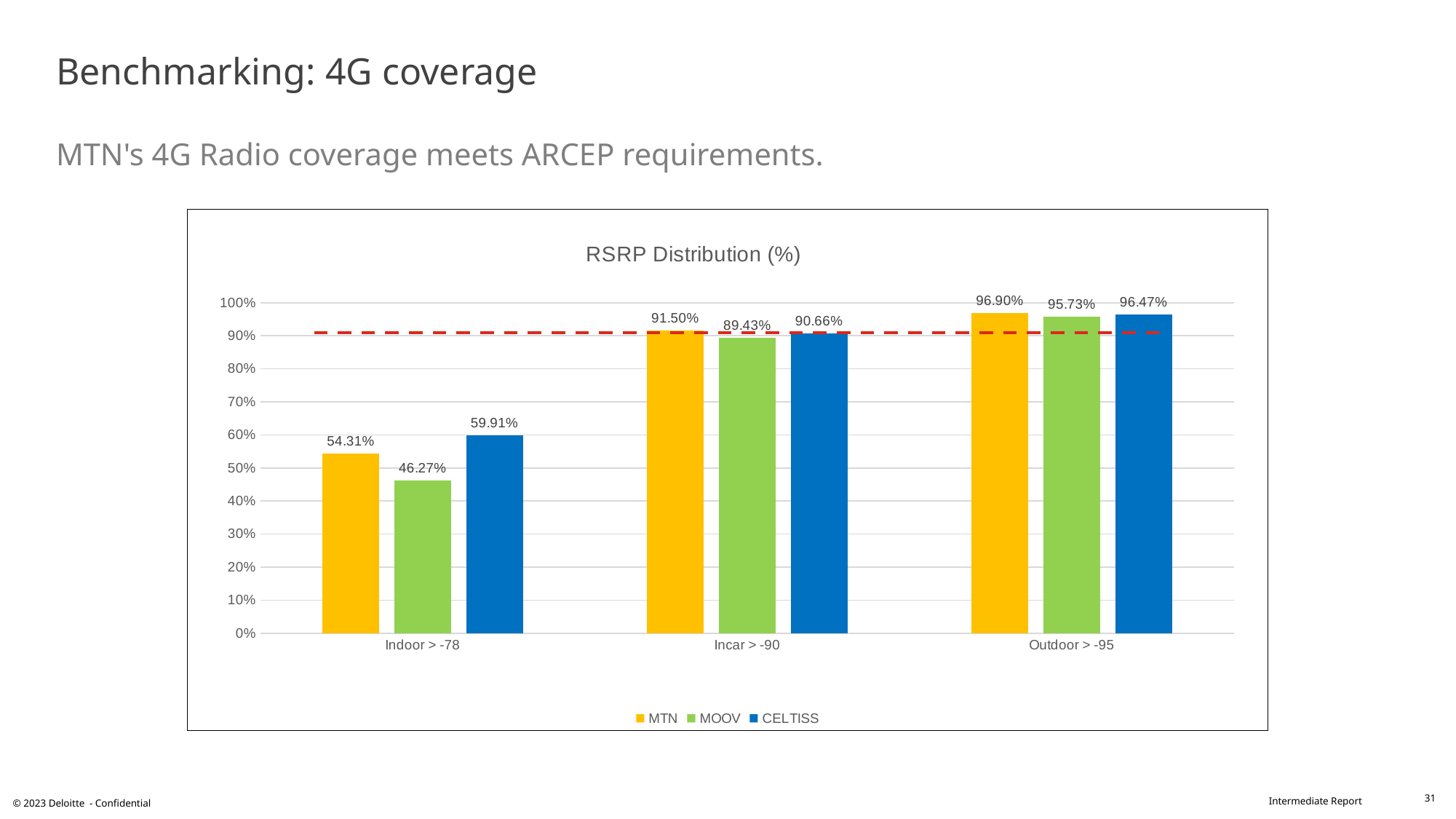
Which operator has the highest value in the Indoor > -78 category? CELTISS What is the value for CELTISS in the Outdoor > -95 category? 96.47% What kind of chart is shown on the slide? Bar chart How many categories are shown on the x axis? 3 What is the title of the chart? RSRP Distribution (%) What is the value for MOOV in the Incar > -90 category? 89.43% What is the value for MTN in the Indoor > -78 category? 54.31% What is the difference between the CELTISS and MOOV values in the Indoor > -78 category? 13.64% Do the MTN values rise or fall from Indoor > -78 to Outdoor > -95? Rise How many series does the legend list? 3 Which is larger in the Incar > -90 category: MTN or CELTISS? MTN Which operator has the lowest value in the Outdoor > -95 category? MOOV